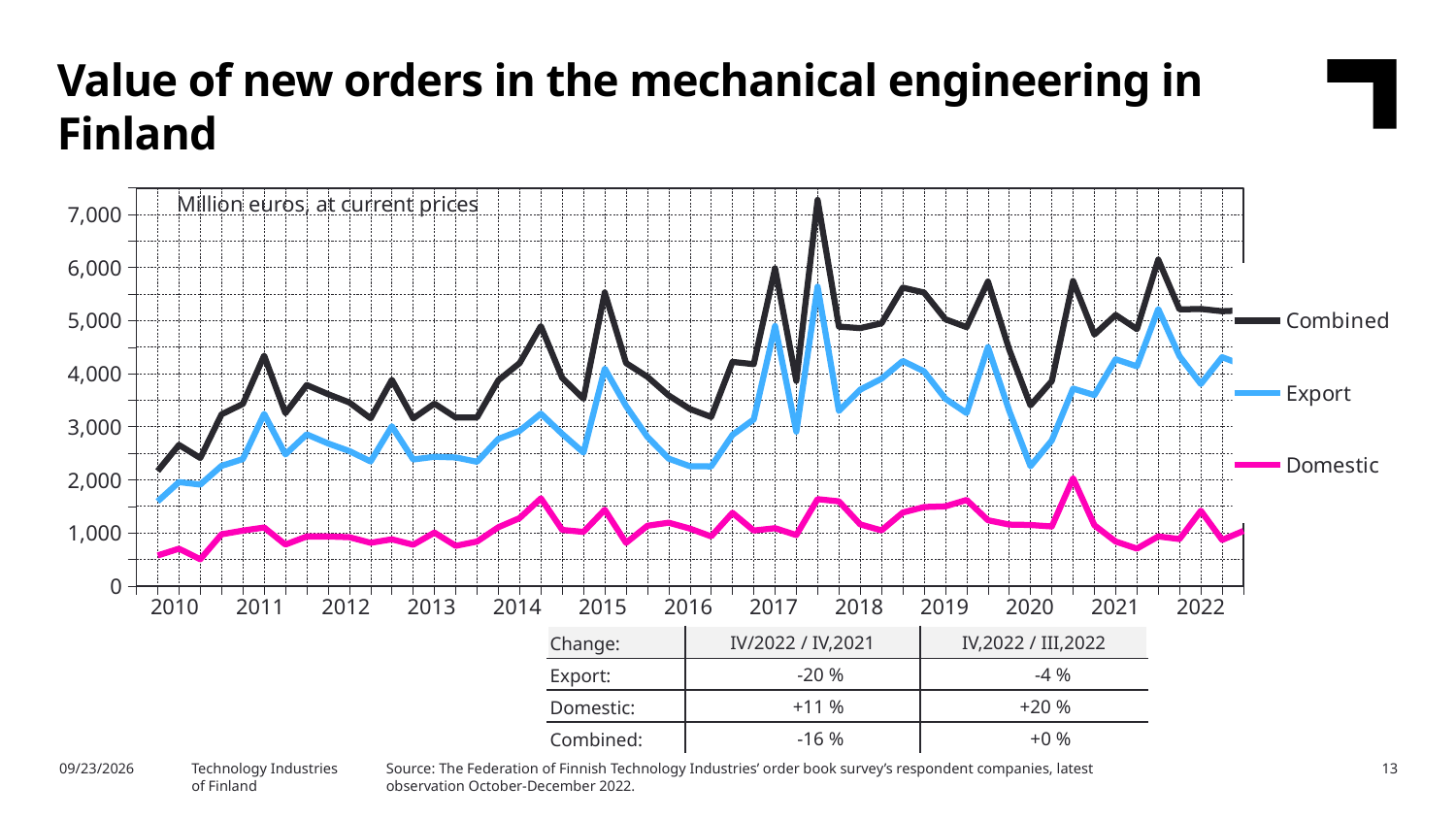
Which series has the highest values throughout the chart? Combined What are the three series named in the chart legend? Combined, Export, Domestic According to the table below the chart, what is the Export change for IV/2022 / IV,2021? -20 % What unit is stated in the label at the top of the chart? Million euros, at current prices Is the Export value at the start of 2010 greater or less than 2,000? less What kind of chart is shown on the slide? line chart Is the Combined value at the start of 2010 greater or less than 3,000? less Which series is larger at the end of 2022, Export or Domestic? Export Is the Domestic value at the start of 2010 greater or less than 1,000? less Which series has the lowest values throughout the chart? Domestic How many series does the chart legend list? 3